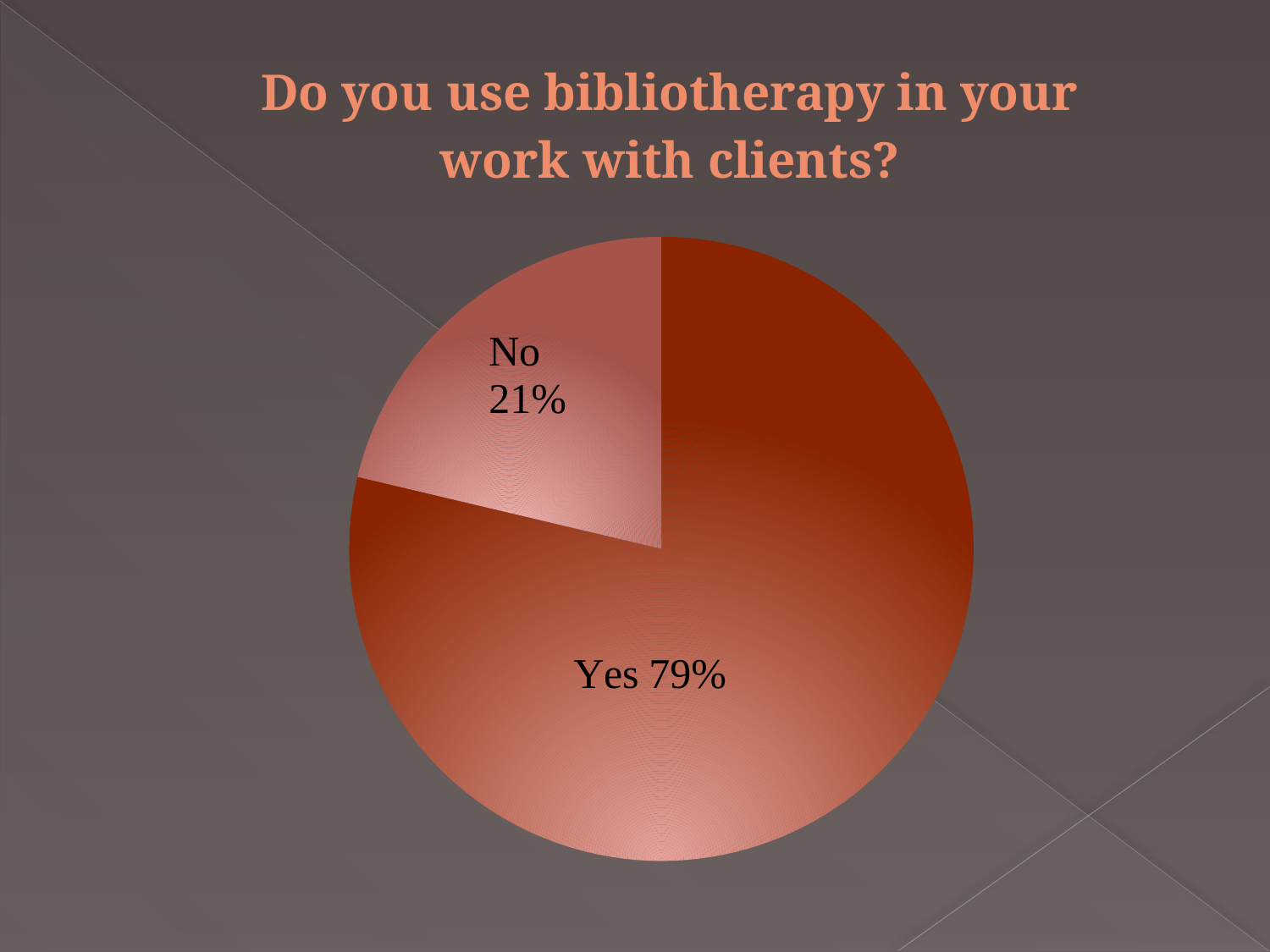
What share of the pie does the No slice represent? 21% How many slices does the pie chart have? 2 Is the Yes slice greater or less than 50% of the pie? greater What percentage of respondents answered Yes? 79% Which response has the largest share of the pie? Yes What kind of chart is shown on the slide? pie chart What is the title of the chart? Do you use bibliotherapy in your work with clients? Which response has the smallest share of the pie? No Which slice is larger, Yes or No? Yes What is the difference in percentage points between the Yes and No slices? 58 What percentage of respondents answered No? 21%